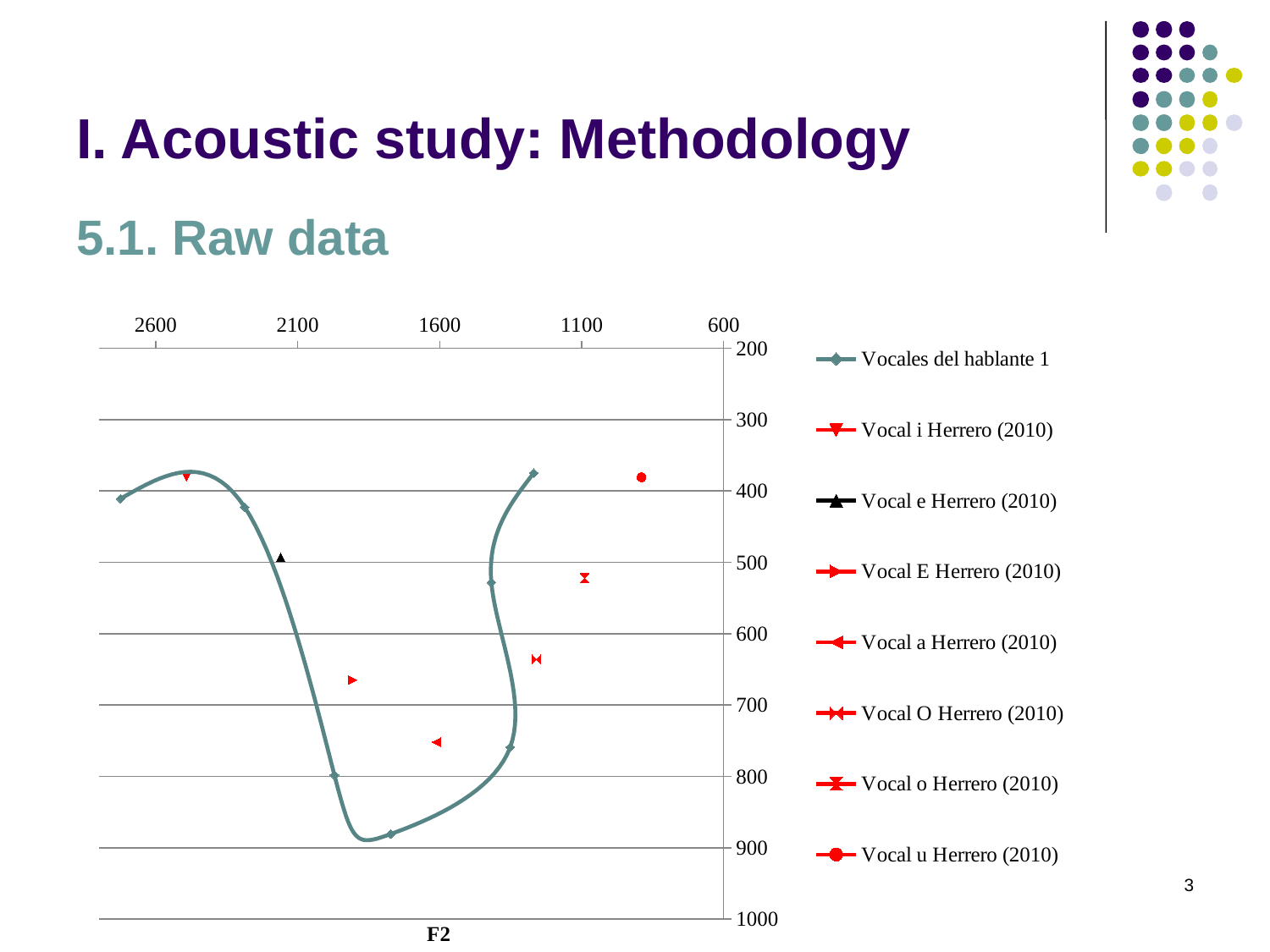
What is the label on the horizontal axis of the chart? F2 Is the vertical-axis value for Vocal E Herrero (2010) greater or less than 600? greater Which legend entry is shown with a teal diamond marker and a connecting line? Vocales del hablante 1 What kind of chart is shown on the slide? scatter chart How many series does the chart legend list? 8 Among the Herrero (2010) vowel points, which has the highest vertical-axis value? Vocal a Herrero (2010) Which has the larger vertical-axis value, Vocal a Herrero (2010) or Vocal u Herrero (2010)? Vocal a Herrero (2010) Is the vertical-axis value for Vocal a Herrero (2010) greater or less than 700? greater Is the vertical-axis value for Vocal u Herrero (2010) greater or less than 400? less